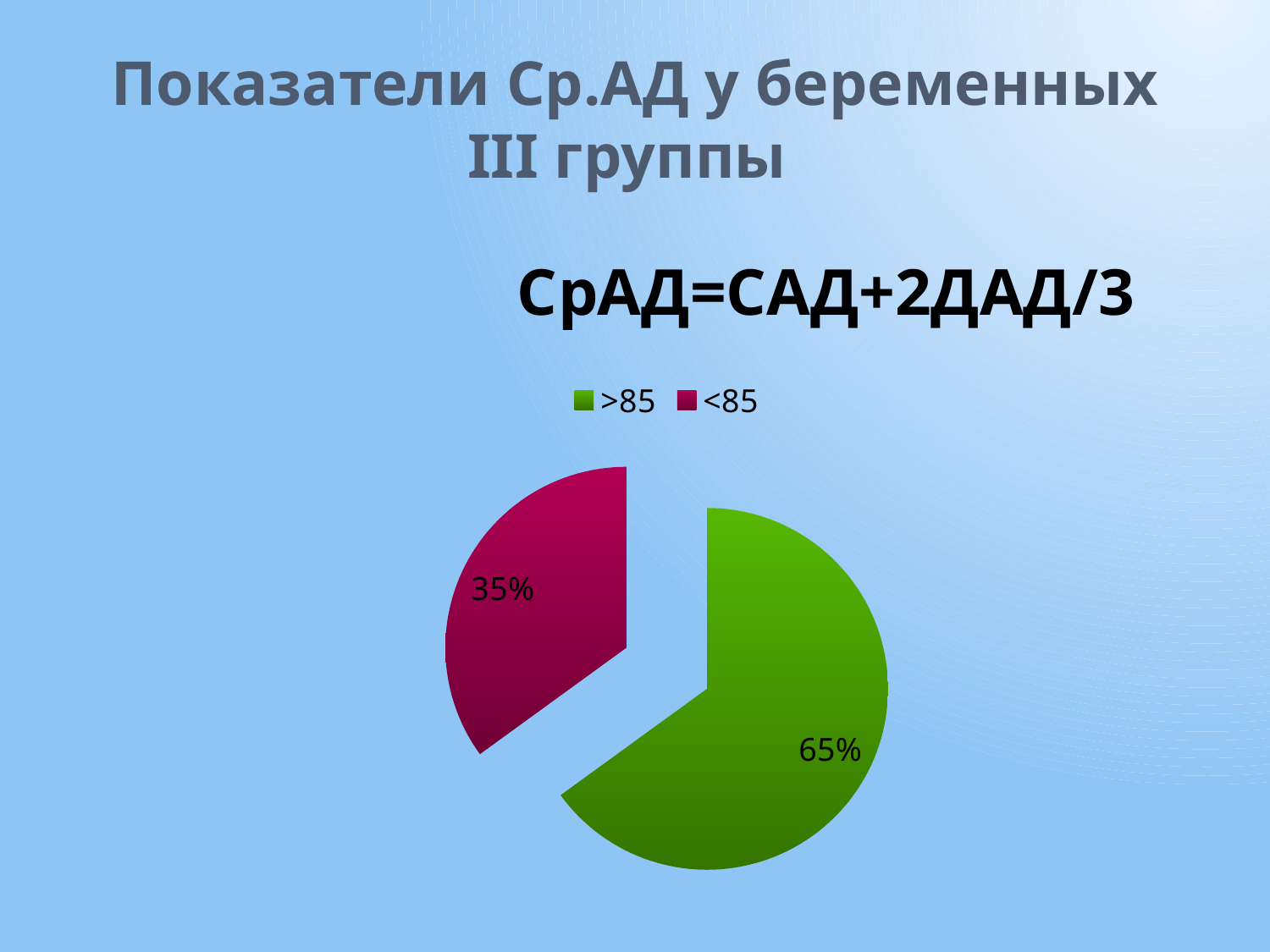
Which category has the largest share of the pie? >85 Which is larger, the >85 slice or the <85 slice? >85 What is the difference between the >85 and <85 shares? 30% What share of the pie does the <85 slice represent? 35% What kind of chart is shown on the slide? pie chart How many slices does the pie chart have? 2 How many entries does the legend list? 2 What colour is the >85 slice? green Which category has the smallest share of the pie? <85 What is the value for the >85 slice? 65% What is the value for the <85 slice? 35% What colour is the <85 slice? magenta